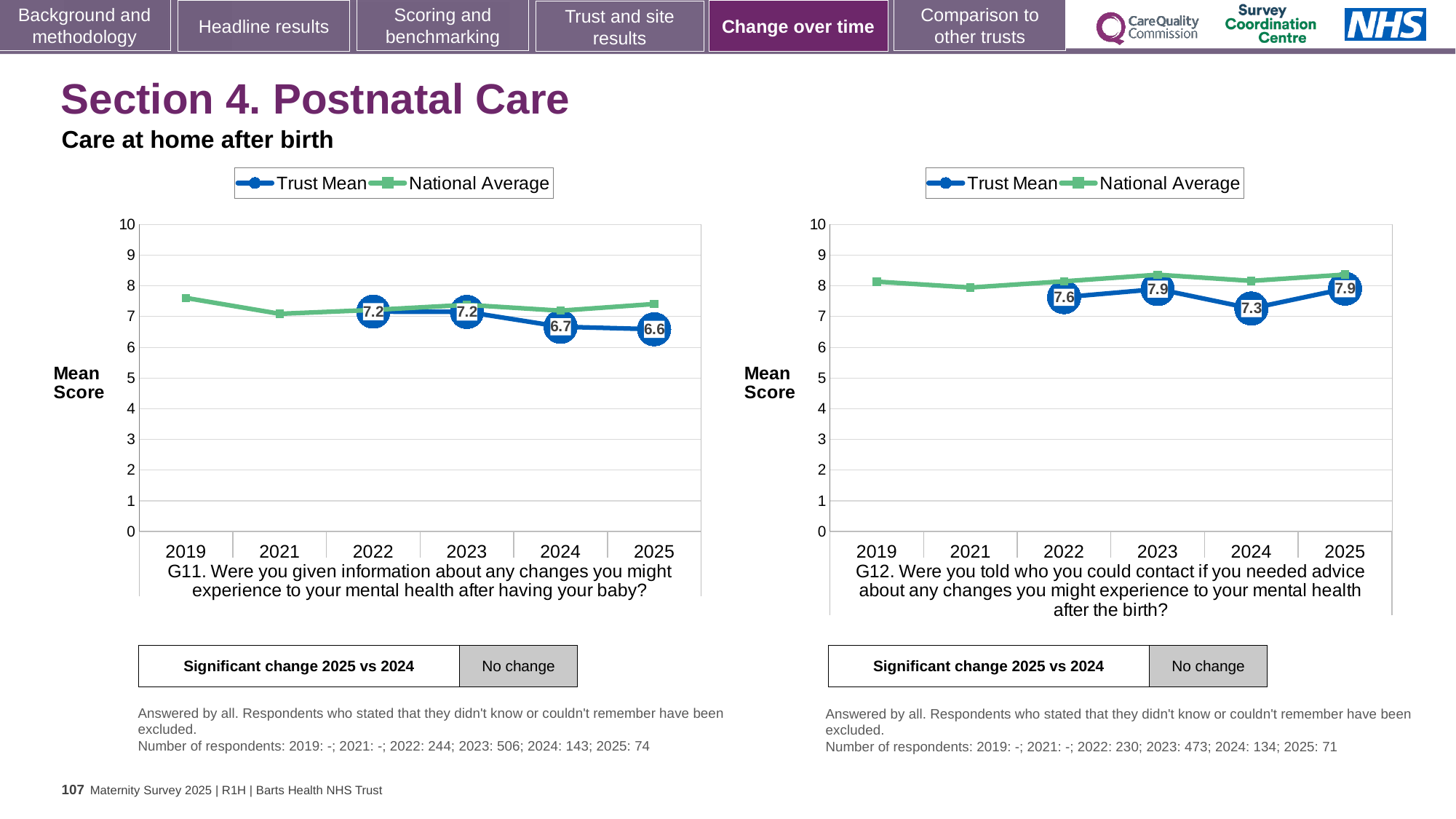
On the G11 chart (left), what is the Trust Mean score for 2022? 7.2 On the G11 chart (left), what is the difference between the Trust Mean scores for 2023 and 2025? 0.6 On the G12 chart (right), which year has the lowest Trust Mean score? 2024 On the G12 chart (right), what is the difference between the Trust Mean scores for 2025 and 2024? 0.6 On the G12 chart (right), what is the Trust Mean score for 2024? 7.3 On the G11 chart (left), which year has the lowest Trust Mean score? 2025 On the G11 chart (left), what is the Trust Mean score for 2025? 6.6 How many series does the legend list on the G12 chart (right)? 2 What kind of chart is the G11 chart (left)? line chart On the G11 chart (left), is the Trust Mean score for 2024 larger or smaller than the Trust Mean score for 2023? smaller On the G11 chart (left), is the National Average value for 2019 greater or less than 7? greater On the G12 chart (right), what is the Trust Mean score for 2022? 7.6